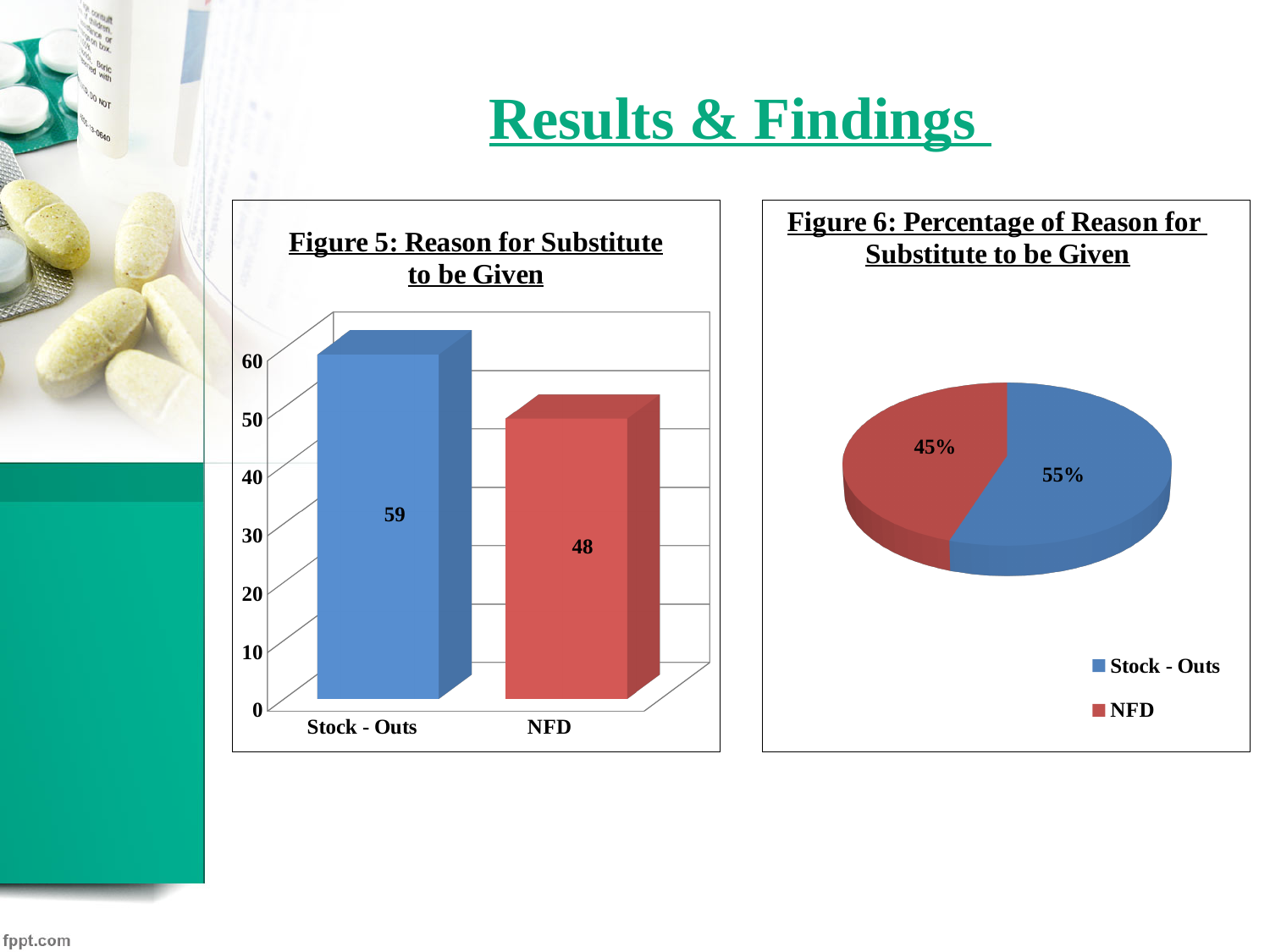
In Figure 6, what percentage is shown for Stock - Outs? 55% What kind of chart is Figure 5? bar chart What kind of chart is Figure 6? pie chart In Figure 6, how many entries does the legend list? 2 In Figure 5, what is the value for NFD? 48 In Figure 6, what percentage is shown for NFD? 45% In Figure 5, which category has the lowest value? NFD In Figure 5, what is the difference between the values for Stock - Outs and NFD? 11 In Figure 5, is the value for NFD greater or less than 50? less In Figure 5, how many categories are shown? 2 In Figure 5, what is the value for Stock - Outs? 59 In Figure 5, which category has the highest value? Stock - Outs